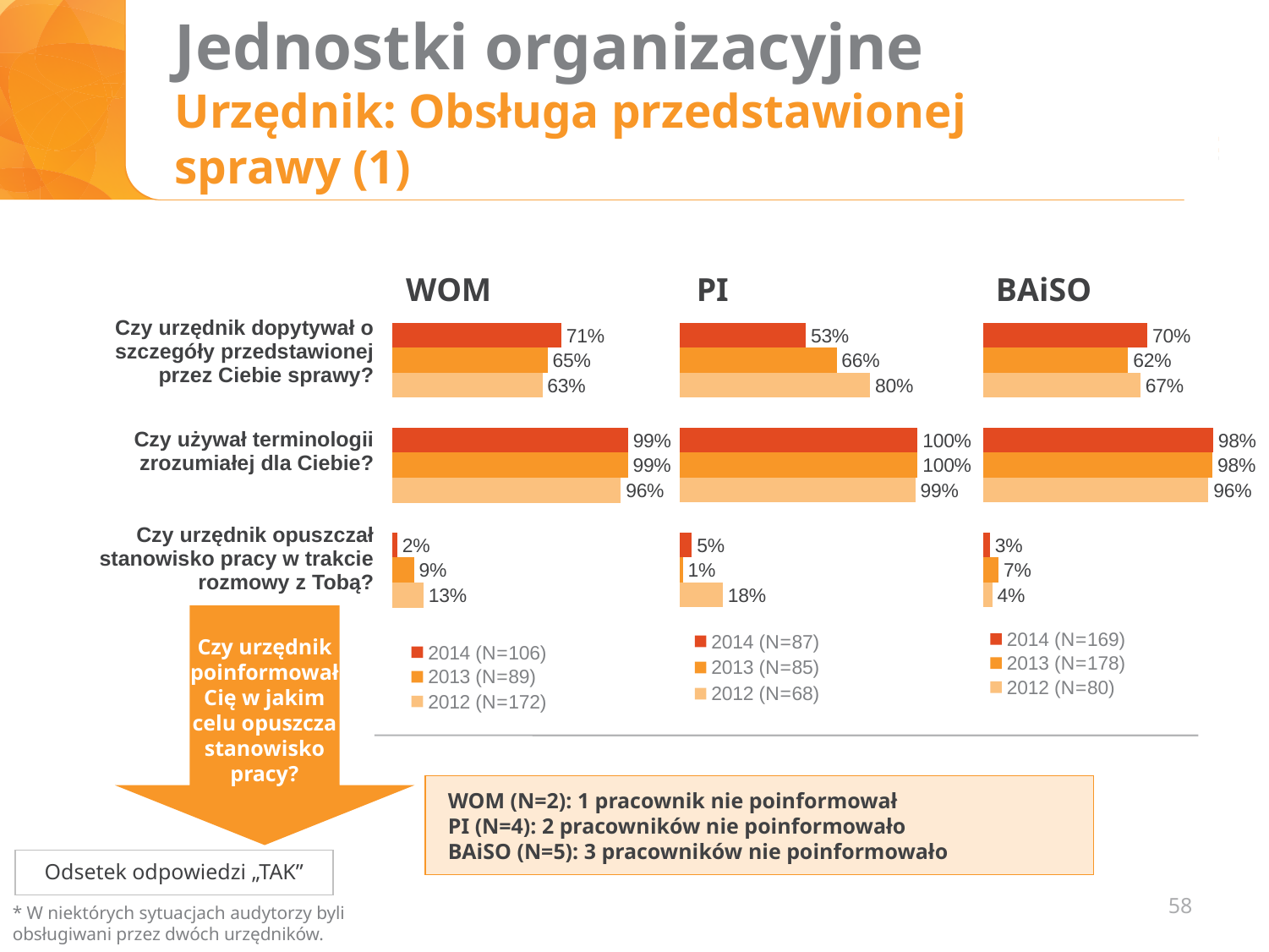
In the BAiSO chart, what is the difference between the 2014 and 2013 values for "Czy urzędnik dopytywał o szczegóły przedstawionej przez Ciebie sprawy?"? 8% In the PI chart, what is the 2014 value for "Czy używał terminologii zrozumiałej dla Ciebie?"? 100% What type of chart is the WOM chart? Bar chart In the PI chart, what is the 2012 value for "Czy urzędnik dopytywał o szczegóły przedstawionej przez Ciebie sprawy?"? 80% How many question categories are shown in the BAiSO chart? 3 In the WOM chart, what is the 2014 value for "Czy urzędnik dopytywał o szczegóły przedstawionej przez Ciebie sprawy?"? 71% How many series does the legend of the PI chart list? 3 In the BAiSO chart, what is the 2013 value for "Czy urzędnik opuszczał stanowisko pracy w trakcie rozmowy z Tobą?"? 7% In the WOM chart, which is larger for "Czy urzędnik dopytywał o szczegóły przedstawionej przez Ciebie sprawy?": the 2013 value or the 2012 value? 2013 (65%) In the WOM chart, which year has the highest value for "Czy urzędnik opuszczał stanowisko pracy w trakcie rozmowy z Tobą?"? 2012 (N=172) What is the sample size (N) for 2013 in the BAiSO chart legend? 178 In the PI chart, which year has the lowest value for "Czy urzędnik dopytywał o szczegóły przedstawionej przez Ciebie sprawy?"? 2014 (N=87)